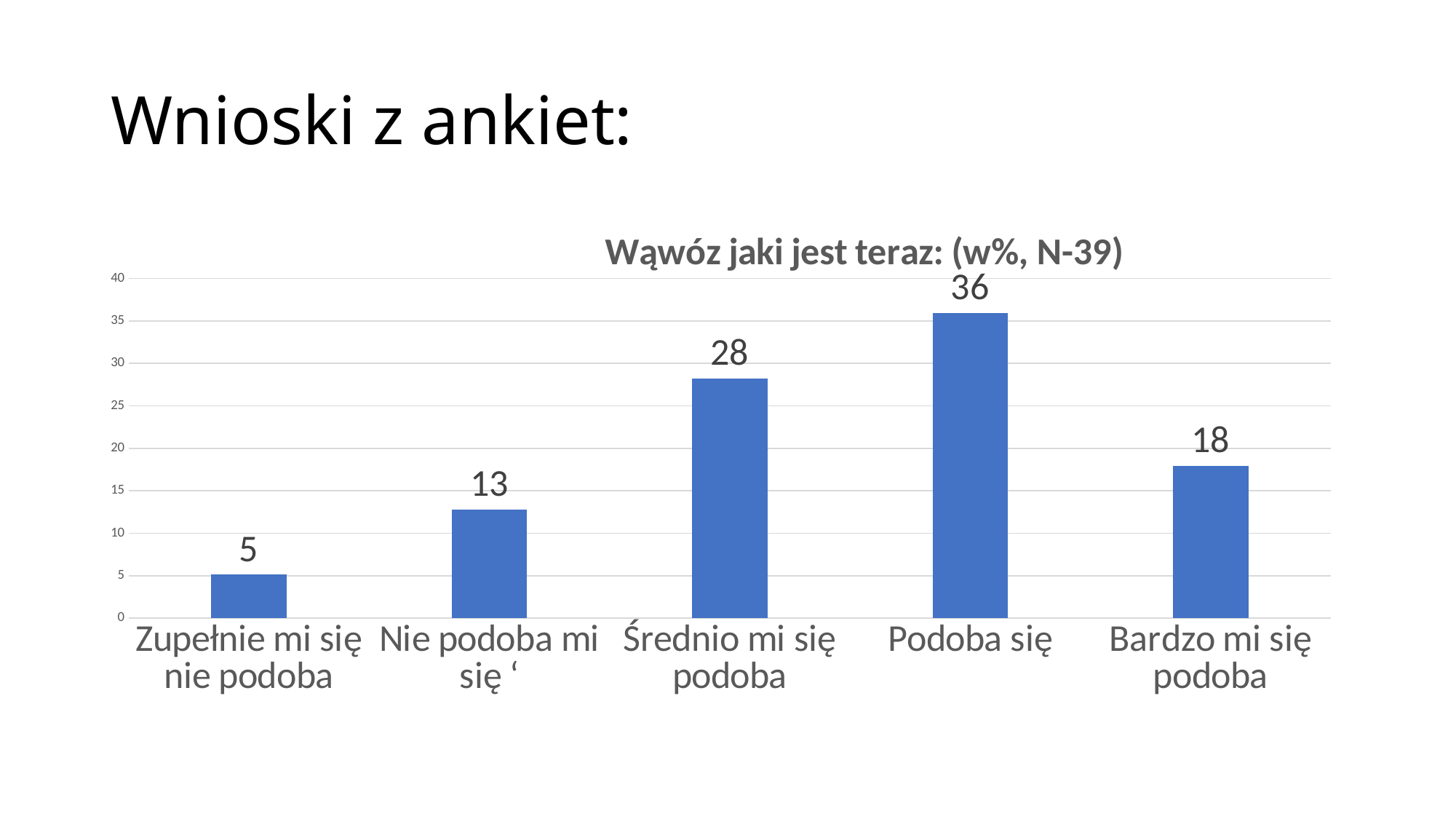
What is the title of the chart? Wąwóz jaki jest teraz: (w%, N-39) What is the difference between the values for "Bardzo mi się podoba" and "Nie podoba mi się"? 5 How many categories are shown on the chart? 5 What is the difference between the values for "Podoba się" and "Średnio mi się podoba"? 8 What is the value for "Podoba się"? 36 What is the value for "Zupełnie mi się nie podoba"? 5 Which is larger, the value for "Średnio mi się podoba" or the value for "Bardzo mi się podoba"? Średnio mi się podoba Is the value for "Nie podoba mi się" greater or less than 15? less What kind of chart is shown on the slide? bar chart Which category has the highest value? Podoba się Which category has the lowest value? Zupełnie mi się nie podoba What is the value for "Bardzo mi się podoba"? 18